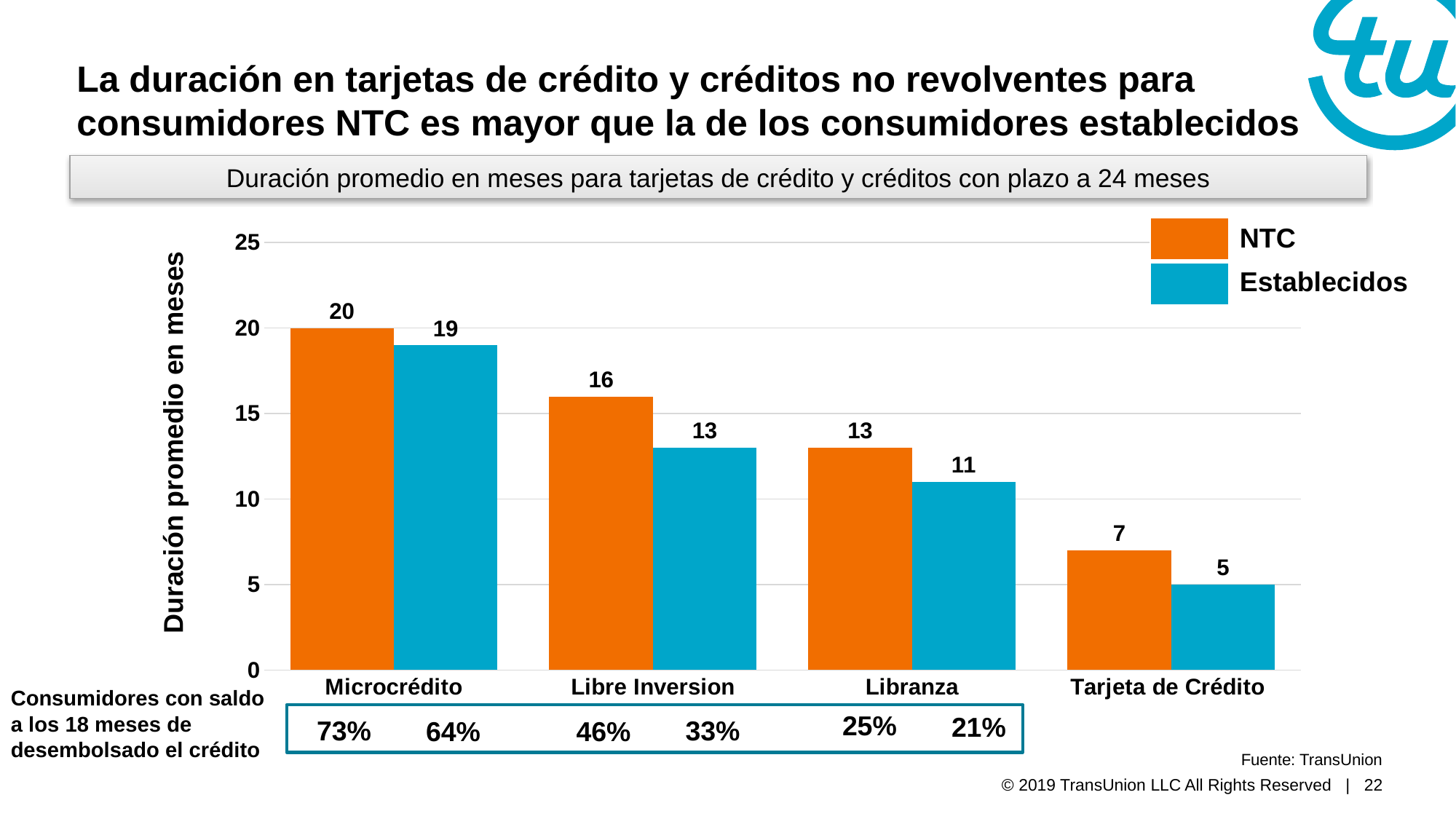
What is the Establecidos value for Libre Inversion? 13 What is the difference between the NTC and Establecidos values for Libre Inversion? 3 What is the y-axis label of the chart? Duración promedio en meses What is the Establecidos value for Tarjeta de Crédito? 5 How many categories are shown on the x axis? 4 Which category has the highest NTC value? Microcrédito Which category has the lowest Establecidos value? Tarjeta de Crédito What kind of chart is shown on the slide? Bar chart What is the NTC value for Microcrédito? 20 How many series does the legend list? 2 Do the NTC values rise or fall from Microcrédito to Tarjeta de Crédito? Fall Which is larger for Libranza, the NTC value or the Establecidos value? NTC